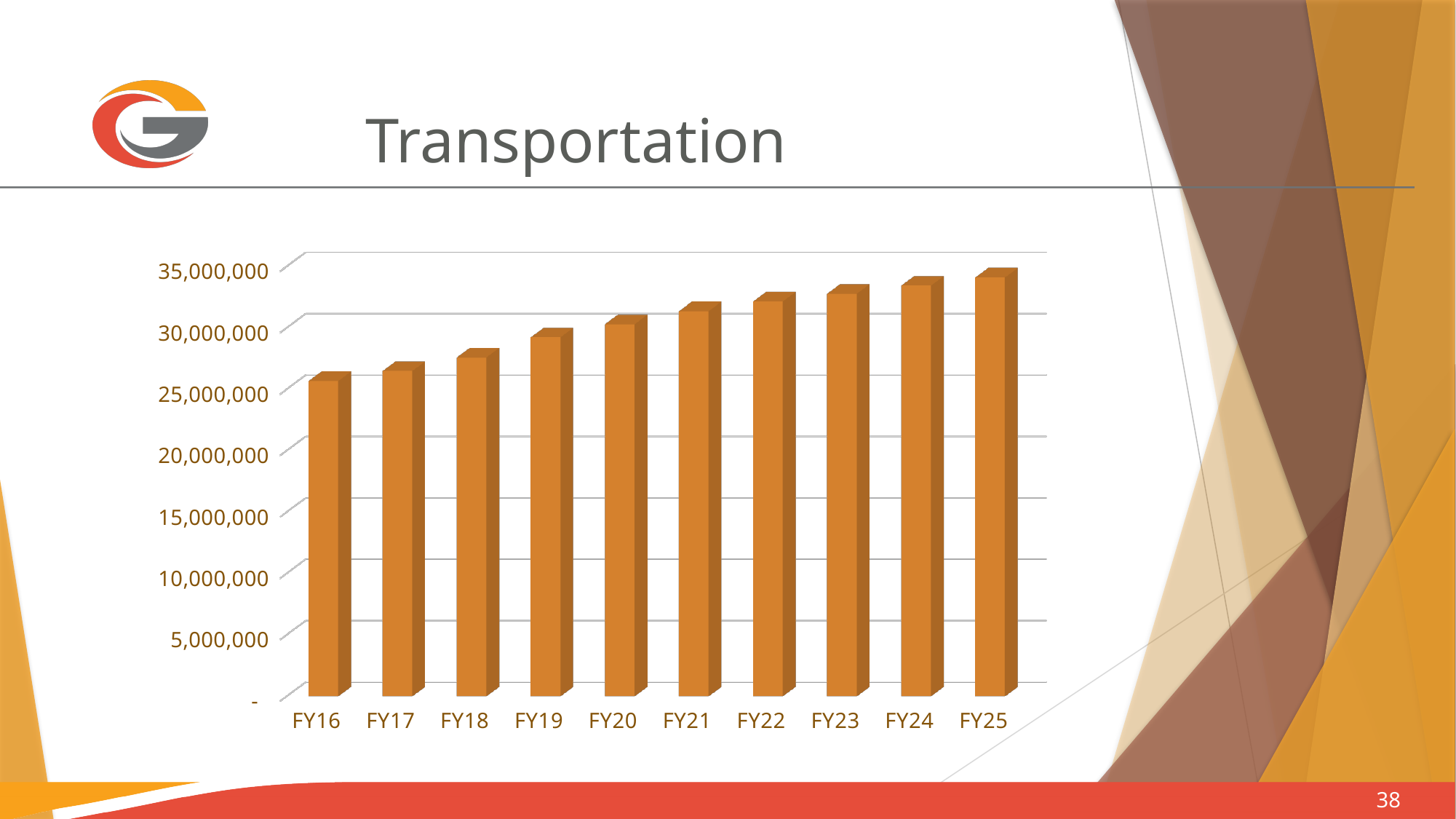
Which fiscal year has the highest bar in the chart? FY25 What kind of chart is shown on the slide? bar chart What is the title of the slide containing the chart? Transportation Is the value for FY25 greater or less than 30,000,000? greater Is the value for FY16 greater or less than 20,000,000? greater Which fiscal year has the lowest bar in the chart? FY16 Is the value for FY16 greater or less than 30,000,000? less Which is larger, the value for FY17 or the value for FY21? FY21 Do the values rise or fall from FY16 to FY25? rise How many fiscal years are plotted on the x axis of the chart? 10 Which is larger, the value for FY25 or the value for FY16? FY25